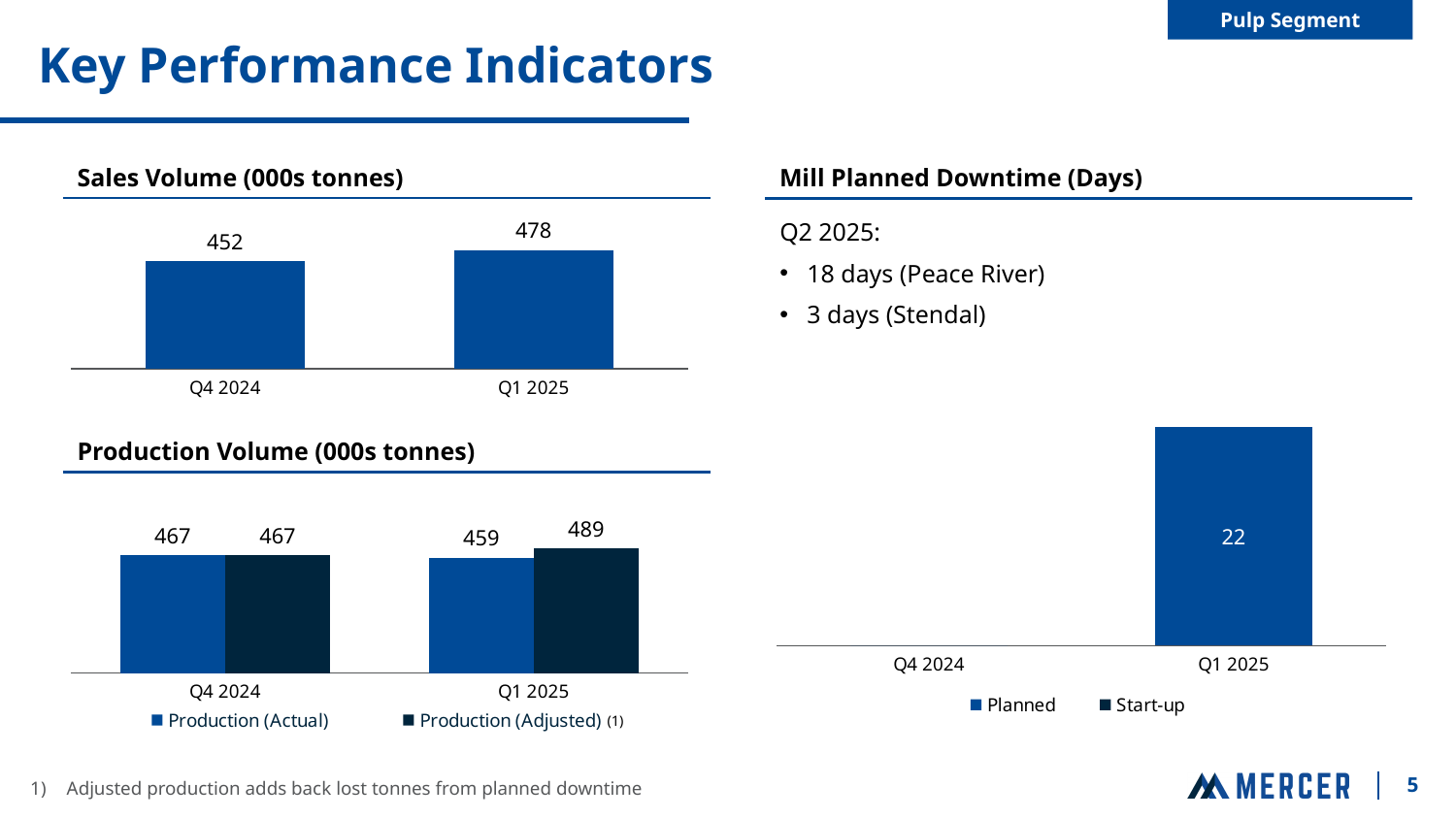
In the Mill Planned Downtime (Days) chart, what is the Planned value for Q1 2025? 22 In the Mill Planned Downtime (Days) chart, how many categories are shown on the x axis? 2 In the Production Volume (000s tonnes) chart, what is the Production (Actual) value for Q1 2025? 459 In the Sales Volume (000s tonnes) chart, what is the value for Q1 2025? 478 What kind of chart is the Sales Volume (000s tonnes) chart? bar chart In the Sales Volume (000s tonnes) chart, do values rise or fall from Q4 2024 to Q1 2025? rise In the Production Volume (000s tonnes) chart, which is larger for Q4 2024: Production (Actual) or Production (Adjusted)? They are equal (467) In the Sales Volume (000s tonnes) chart, what is the difference between Q1 2025 and Q4 2024? 26 In the Sales Volume (000s tonnes) chart, what is the value for Q4 2024? 452 In the Production Volume (000s tonnes) chart, what is the difference between Production (Adjusted) and Production (Actual) for Q1 2025? 30 In the Production Volume (000s tonnes) chart, what is the Production (Adjusted) value for Q1 2025? 489 In the Production Volume (000s tonnes) chart, how many series does the legend list? 2